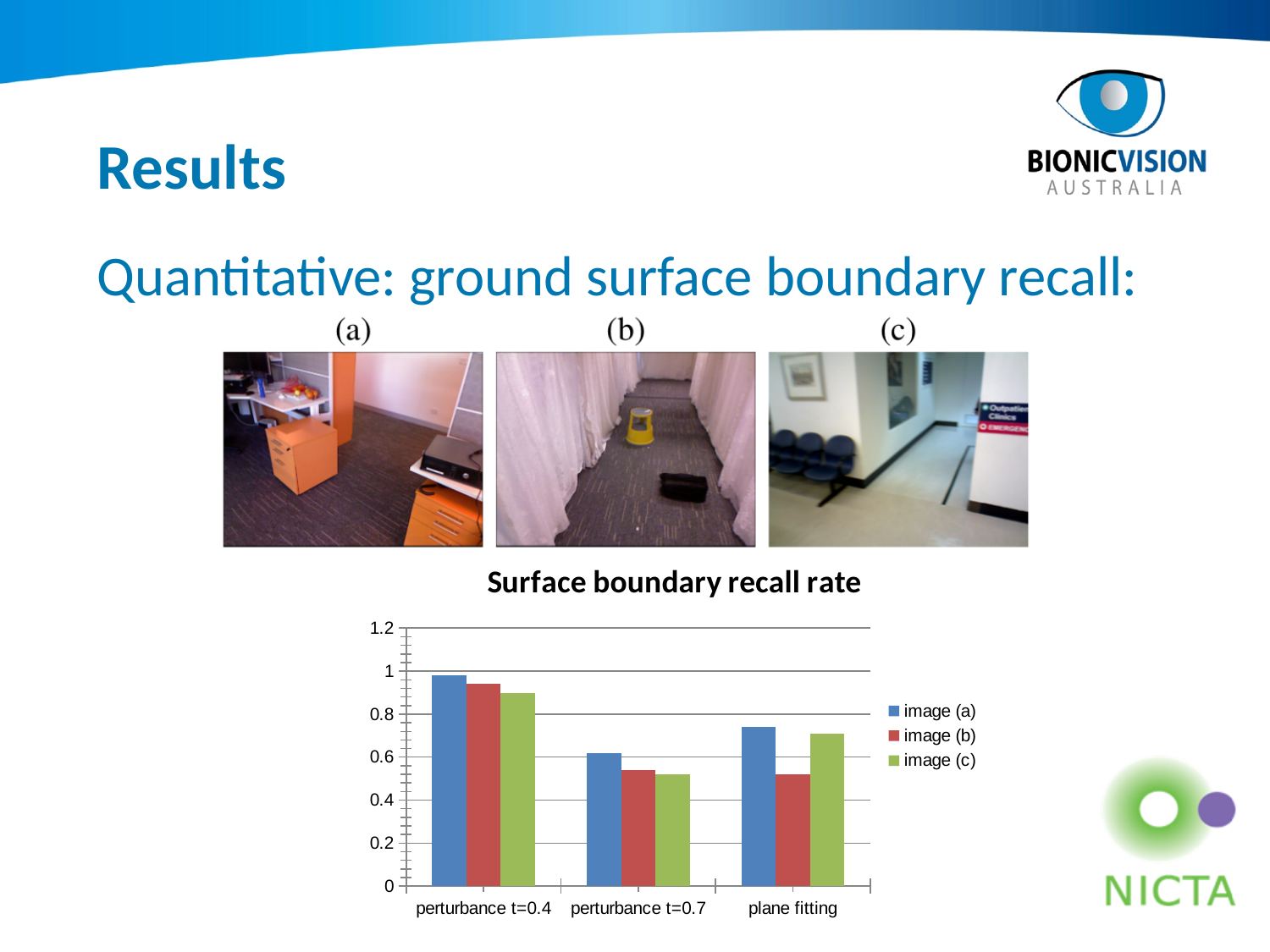
Is the value for image (a) at perturbance t=0.4 greater or less than 0.8? greater How many categories are shown on the x axis of the chart? 3 For which category is the image (c) value lowest? perturbance t=0.7 What colour represents image (b) in the chart? red What is the title of the chart? Surface boundary recall rate What kind of chart is shown on the slide? bar chart How many series does the chart's legend list? 3 Is the value for image (c) at perturbance t=0.7 greater or less than 0.6? less For which category is the image (a) value highest? perturbance t=0.4 At perturbance t=0.4, which is larger: image (a) or image (c)? image (a) At plane fitting, which is larger: image (a) or image (b)? image (a) Is the value for image (b) at plane fitting greater or less than 0.6? less